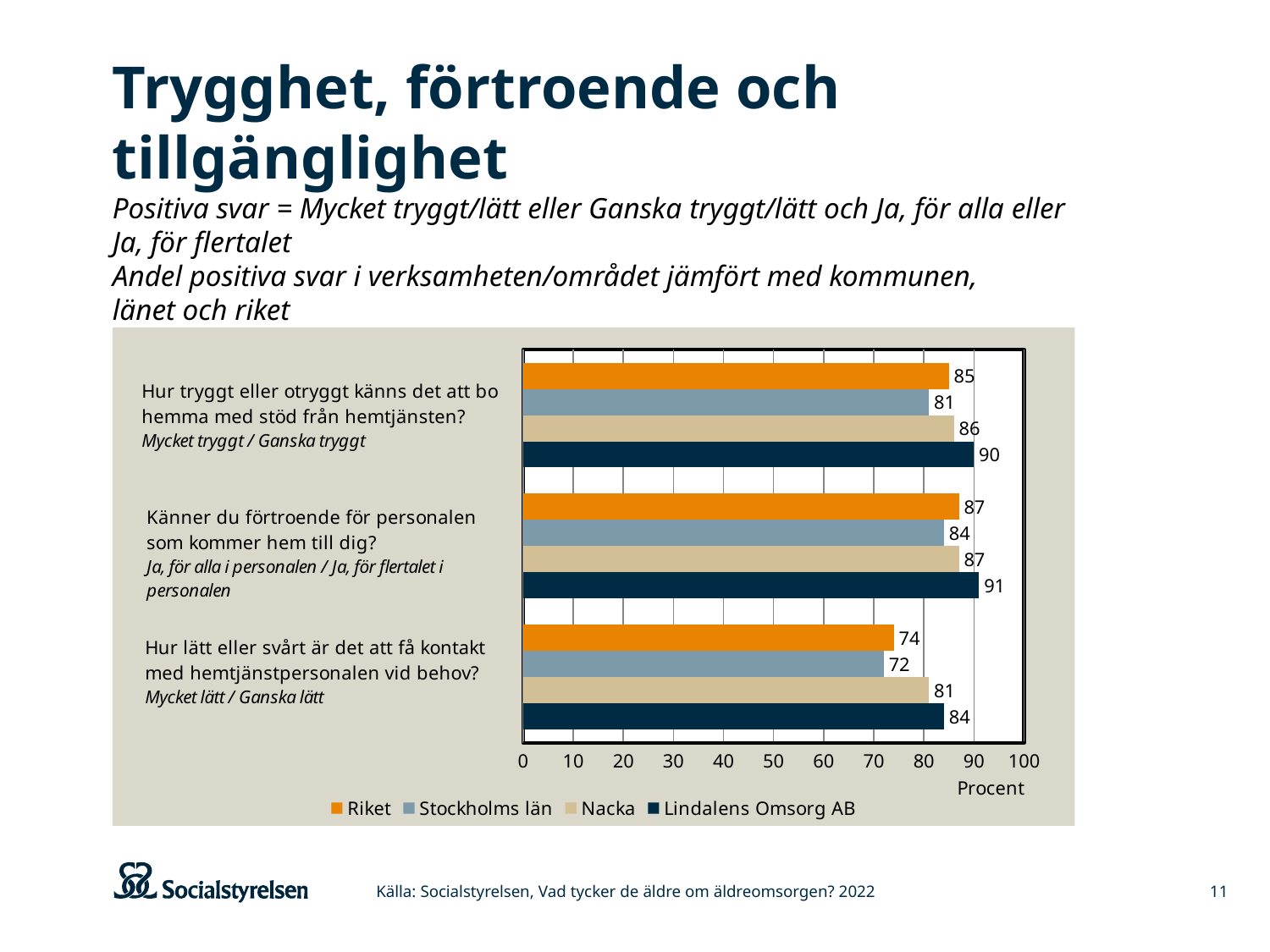
Which series has the lowest value on the question "Hur lätt eller svårt är det att få kontakt med hemtjänstpersonalen vid behov?"? Stockholms län What is the difference between Lindalens Omsorg AB and Riket on the question "Hur lätt eller svårt är det att få kontakt med hemtjänstpersonalen vid behov?"? 10 Is the value for Riket on the question "Hur lätt eller svårt är det att få kontakt med hemtjänstpersonalen vid behov?" greater or less than 80? less Which series has the highest value on the question "Känner du förtroende för personalen som kommer hem till dig?"? Lindalens Omsorg AB What kind of chart is shown on the slide? Bar chart What is the difference between Nacka and Stockholms län on the question "Hur tryggt eller otryggt känns det att bo hemma med stöd från hemtjänsten?"? 5 How many series does the legend list? 4 What is the value for Stockholms län on the question "Hur lätt eller svårt är det att få kontakt med hemtjänstpersonalen vid behov?"? 72 What is the value for Lindalens Omsorg AB on the question "Hur tryggt eller otryggt känns det att bo hemma med stöd från hemtjänsten?"? 90 Which is larger on the question "Hur tryggt eller otryggt känns det att bo hemma med stöd från hemtjänsten?": Riket or Nacka? Nacka What is the value for Nacka on the question "Känner du förtroende för personalen som kommer hem till dig?"? 87 How many question categories are shown on the chart? 3